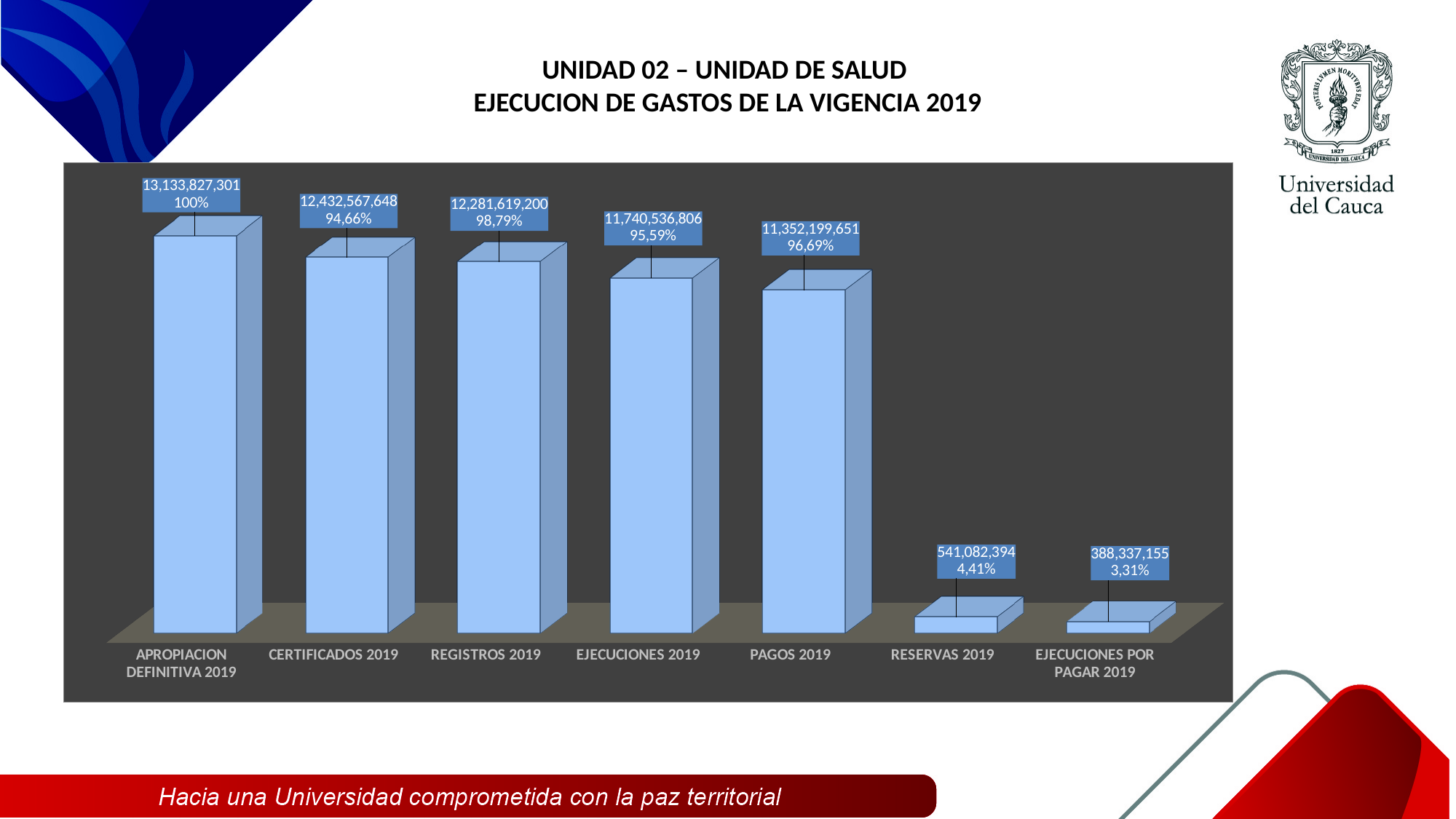
How many categories are shown in the chart? 7 What percentage is shown for EJECUCIONES POR PAGAR 2019? 3,31% What is the difference between the values for RESERVAS 2019 and EJECUCIONES POR PAGAR 2019? 152,745,239 What is the value shown for APROPIACION DEFINITIVA 2019? 13,133,827,301 What kind of chart is shown on the slide? Bar chart Which category has the highest value? APROPIACION DEFINITIVA 2019 What is the value shown for PAGOS 2019? 11,352,199,651 What percentage is shown for REGISTROS 2019? 98,79% Which is larger, the value for EJECUCIONES 2019 or the value for PAGOS 2019? EJECUCIONES 2019 Which category has the lowest value? EJECUCIONES POR PAGAR 2019 What is the value shown for RESERVAS 2019? 541,082,394 What is the difference between the values for APROPIACION DEFINITIVA 2019 and CERTIFICADOS 2019? 701,259,653